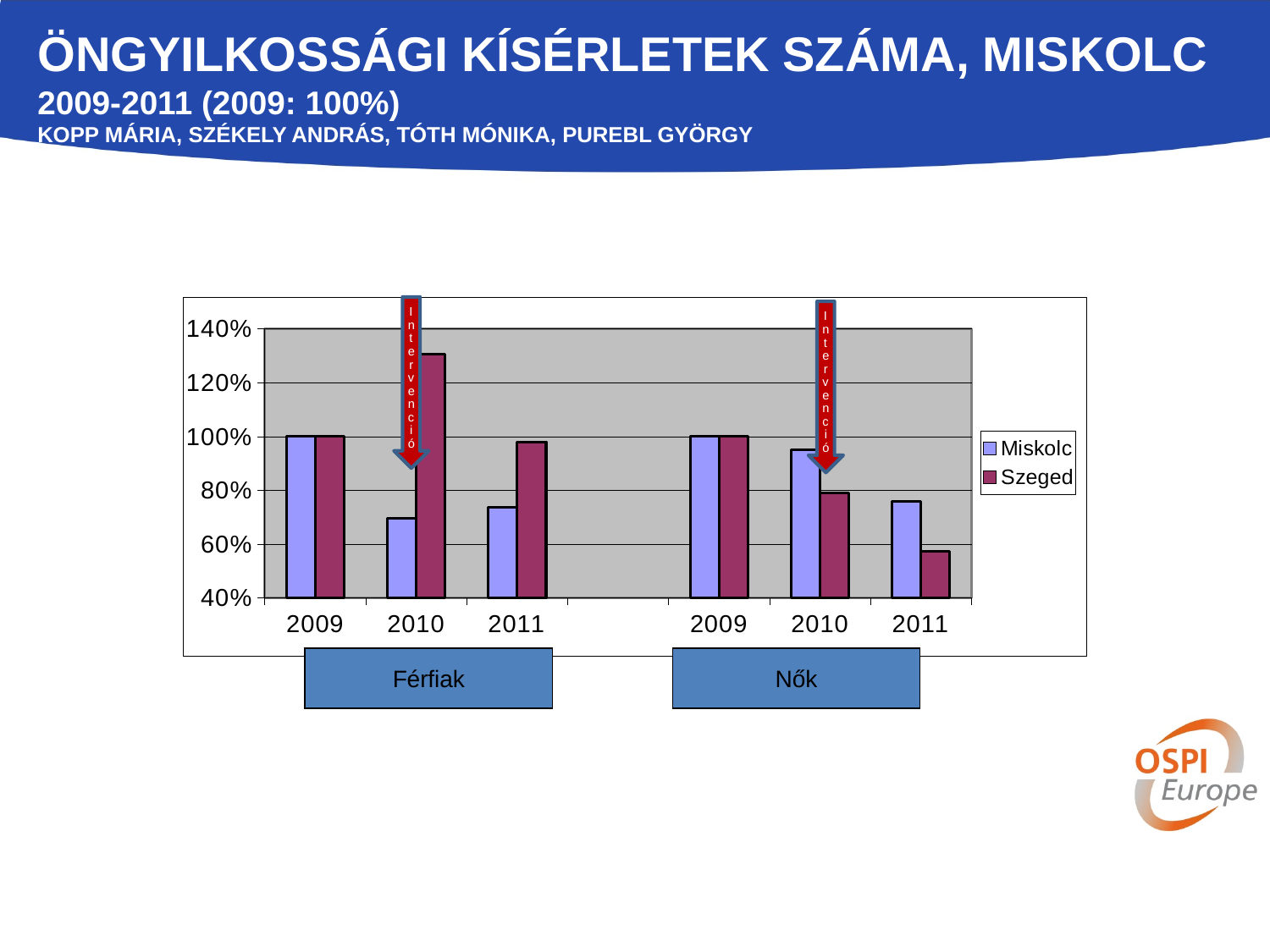
In the Nők group in 2010, which is larger, Miskolc or Szeged? Miskolc Which bar is the highest in the chart? Szeged, 2010, Férfiak Does the Szeged series in the Nők group rise or fall from 2009 to 2011? fall What is the value for Szeged in 2009 in the Nők group? 100% What kind of chart is shown on the slide? bar chart How many series does the chart legend list? 2 Is the value for Miskolc in 2010 in the Férfiak group greater or less than 80%? less Is the value for Szeged in 2011 in the Nők group greater or less than 80%? less Which two series are listed in the chart legend? Miskolc and Szeged In the Férfiak group in 2010, which is larger, Miskolc or Szeged? Szeged Is the value for Szeged in 2010 in the Férfiak group greater or less than 120%? greater What is the value for Miskolc in 2009 in the Férfiak group? 100%